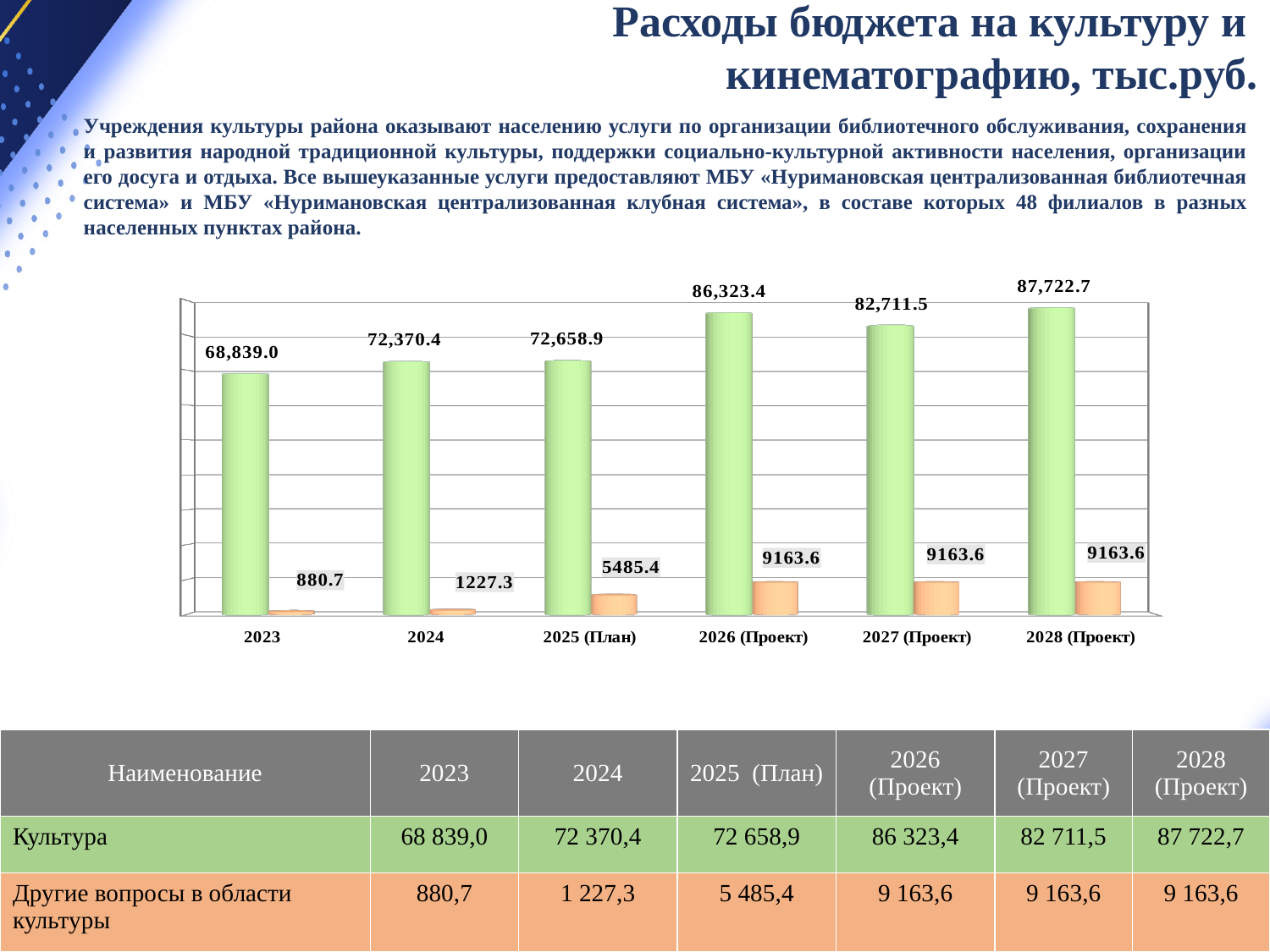
What is the difference between the orange bar values for 2026 (Проект) and 2023? 8282.9 Do the orange bar values rise or fall from 2023 to 2025 (План)? rise How many categories are shown on the x axis of the chart? 6 What kind of chart is shown on the slide? bar chart Which category has the highest green bar? 2028 (Проект) Which category has the lowest orange bar? 2023 What is the difference between the green bar values for 2028 (Проект) and 2023? 18,883.7 What is the value of the orange bar for 2024? 1227.3 What is the value of the orange bar for 2025 (План)? 5485.4 Which is larger, the green bar for 2026 (Проект) or the green bar for 2027 (Проект)? 2026 (Проект) What is the value of the green bar for 2023? 68,839.0 What is the value of the green bar for 2027 (Проект)? 82,711.5